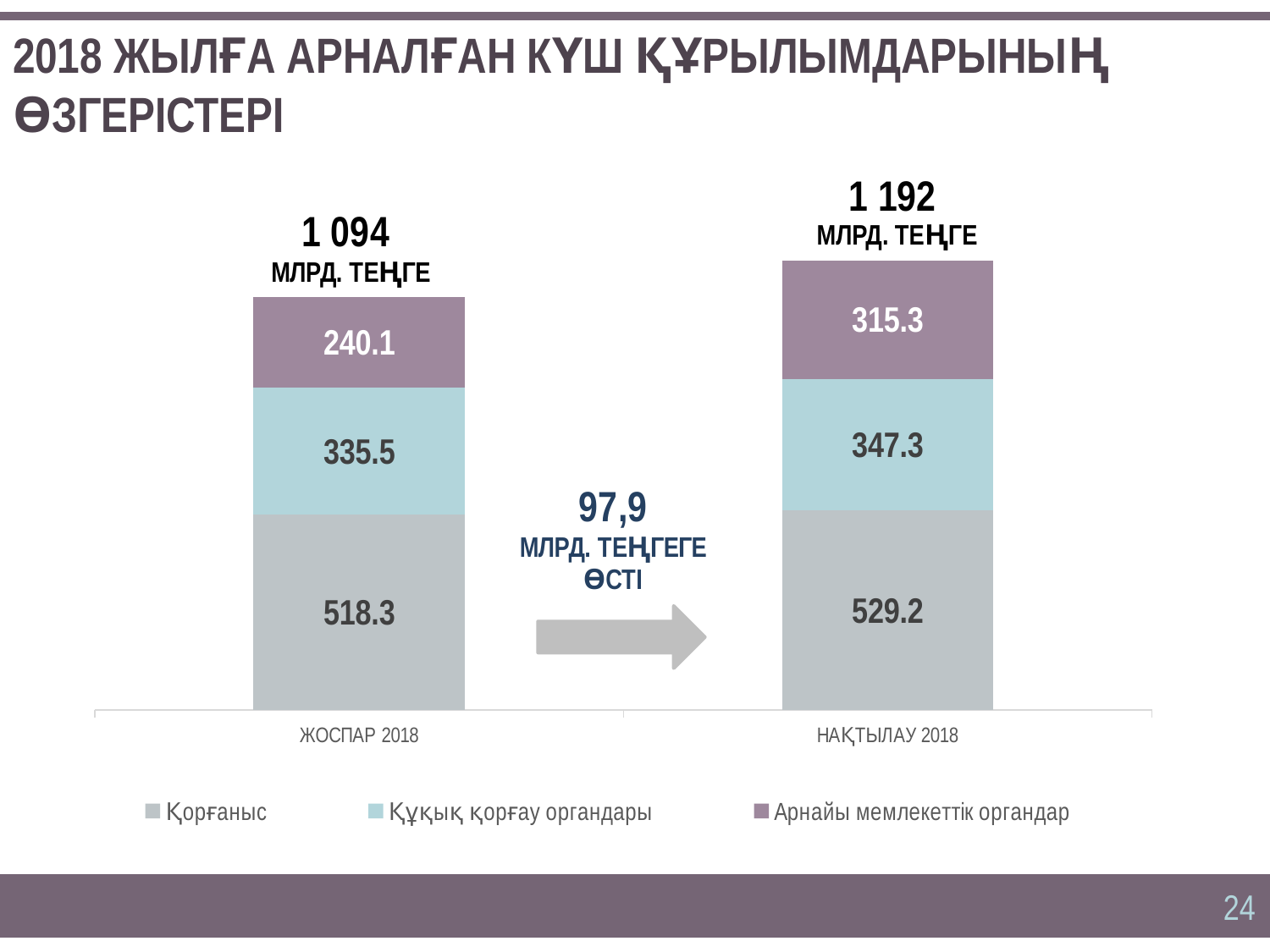
What is the total of the stacked bar for ЖОСПАР 2018? 1 094 Which series has the largest segment in the НАҚТЫЛАУ 2018 bar? Қорғаныс How many series does the legend list? 3 What is the value for Қорғаныс in ЖОСПАР 2018? 518.3 What is the value for Арнайы мемлекеттік органдар in НАҚТЫЛАУ 2018? 315.3 What is the value for Құқық қорғау органдары in ЖОСПАР 2018? 335.5 How many categories are shown on the x axis? 2 Which series has the smallest segment in the ЖОСПАР 2018 bar? Арнайы мемлекеттік органдар What kind of chart is shown on the slide? Stacked bar chart What is the total of the stacked bar for НАҚТЫЛАУ 2018? 1 192 What is the difference between the Арнайы мемлекеттік органдар values for НАҚТЫЛАУ 2018 and ЖОСПАР 2018? 75.2 Which is larger: Құқық қорғау органдары in ЖОСПАР 2018 or in НАҚТЫЛАУ 2018? НАҚТЫЛАУ 2018